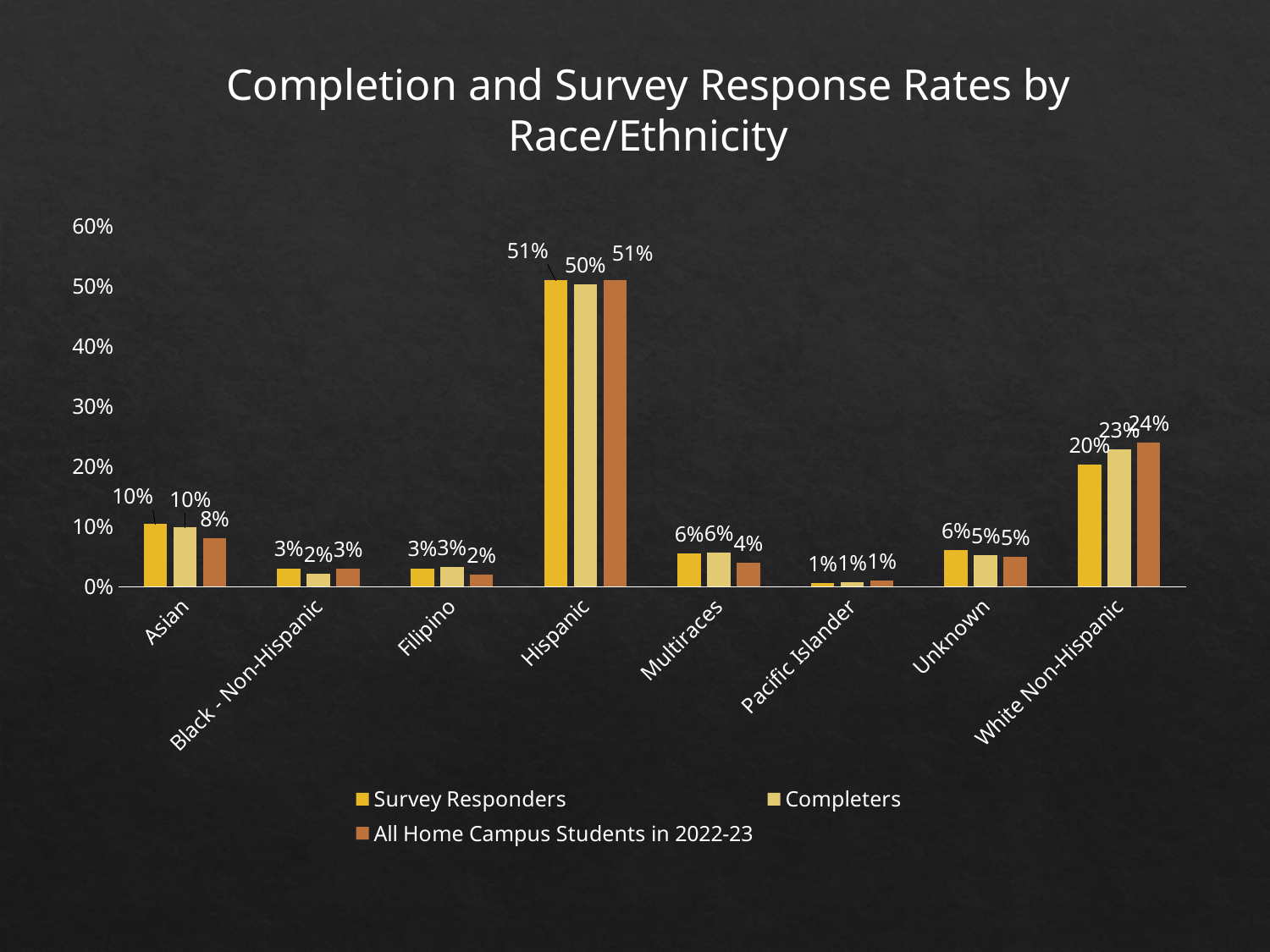
What is the difference between the All Home Campus Students in 2022-23 value and the Survey Responders value for White Non-Hispanic? 4% Which category has the lowest Survey Responders value? Pacific Islander What is the Completers value for White Non-Hispanic? 23% Which category has the highest Completers value? Hispanic What type of chart is shown on the slide? Bar chart What is the Survey Responders value for Hispanic? 51% How many race/ethnicity categories are shown on the x axis? 8 What is the title of the chart? Completion and Survey Response Rates by Race/Ethnicity How many series does the legend list? 3 For Multiraces, which is larger: the Completers value or the All Home Campus Students in 2022-23 value? Completers What is the All Home Campus Students in 2022-23 value for Asian? 8% Is the Survey Responders value for Hispanic greater or less than 40%? greater